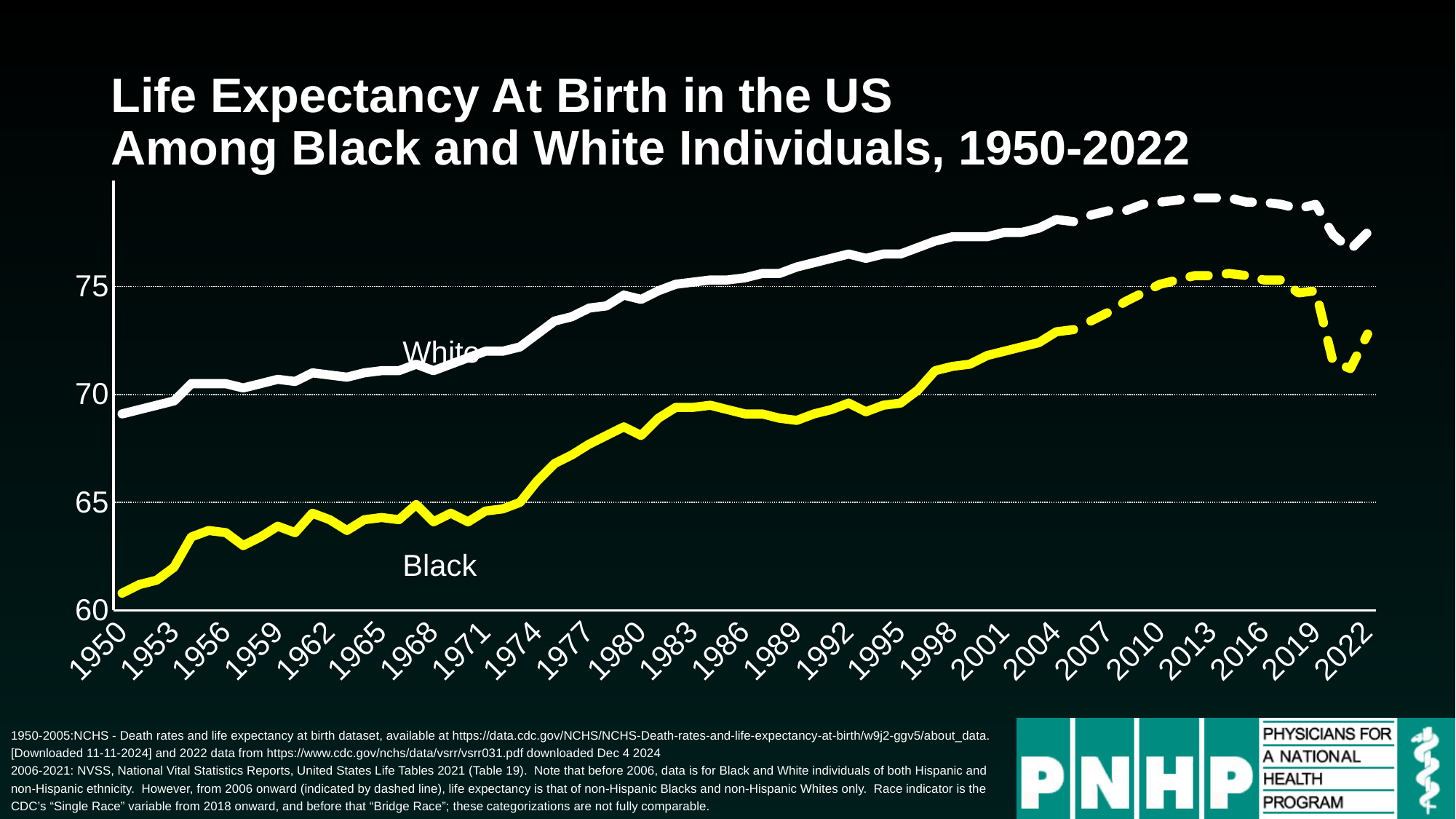
Does the Black life expectancy line generally rise or fall from 1950 to 2013? rise Which series has the higher value in 2000, White or Black? White Is the value for White in 1950 greater or less than 70? less What is the title of the chart? Life Expectancy At Birth in the US Among Black and White Individuals, 1950-2022 Is the value for Black in 2004 greater or less than 70? greater Is the value for Black in 1986 greater or less than 70? less What colour is the line for Black individuals? yellow How many series (lines) are plotted on the chart? 2 What kind of chart is shown on the slide? line chart